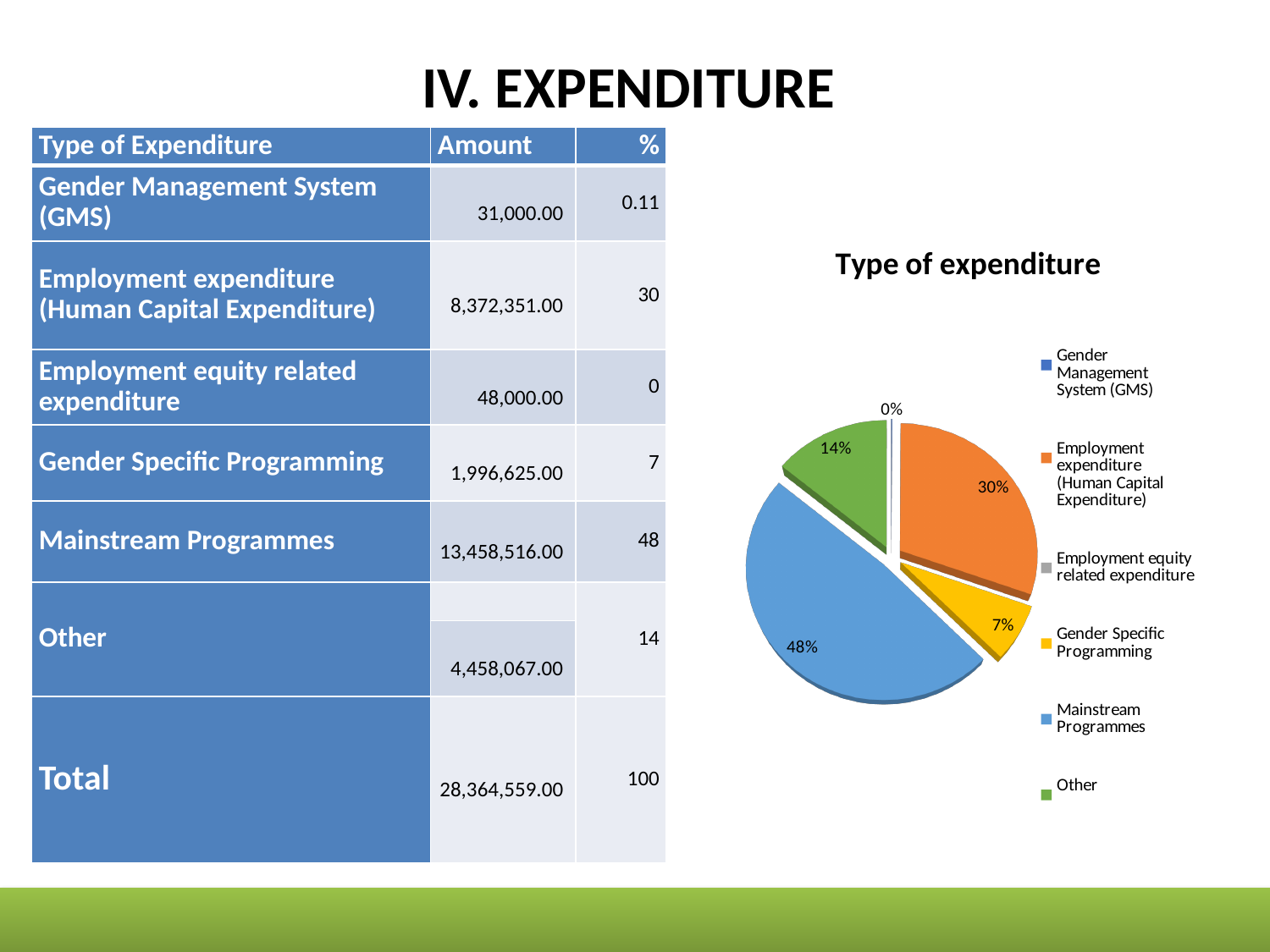
Which category has the largest slice in the 'Type of expenditure' pie chart? Mainstream Programmes What is the title of the pie chart? Type of expenditure In the pie chart, which is larger: the slice for Gender Specific Programming or the slice for Other? Other In the 'Type of expenditure' pie chart, what share is labelled for Mainstream Programmes? 48% In the 'Type of expenditure' pie chart, what share is labelled for Gender Specific Programming? 7% What kind of chart is shown on the slide? Pie chart In the pie chart, what is the difference in percentage points between the Other share and the Gender Specific Programming share? 7 percentage points In the pie chart, which is larger: the slice for Employment expenditure (Human Capital Expenditure) or the slice for Other? Employment expenditure (Human Capital Expenditure) How many categories does the legend of the pie chart list? 6 In the pie chart, how many percentage points larger is the Mainstream Programmes share than the Employment expenditure (Human Capital Expenditure) share? 18 percentage points In the 'Type of expenditure' pie chart, what share is labelled for Employment expenditure (Human Capital Expenditure)? 30% In the 'Type of expenditure' pie chart, what share is labelled for Other? 14%